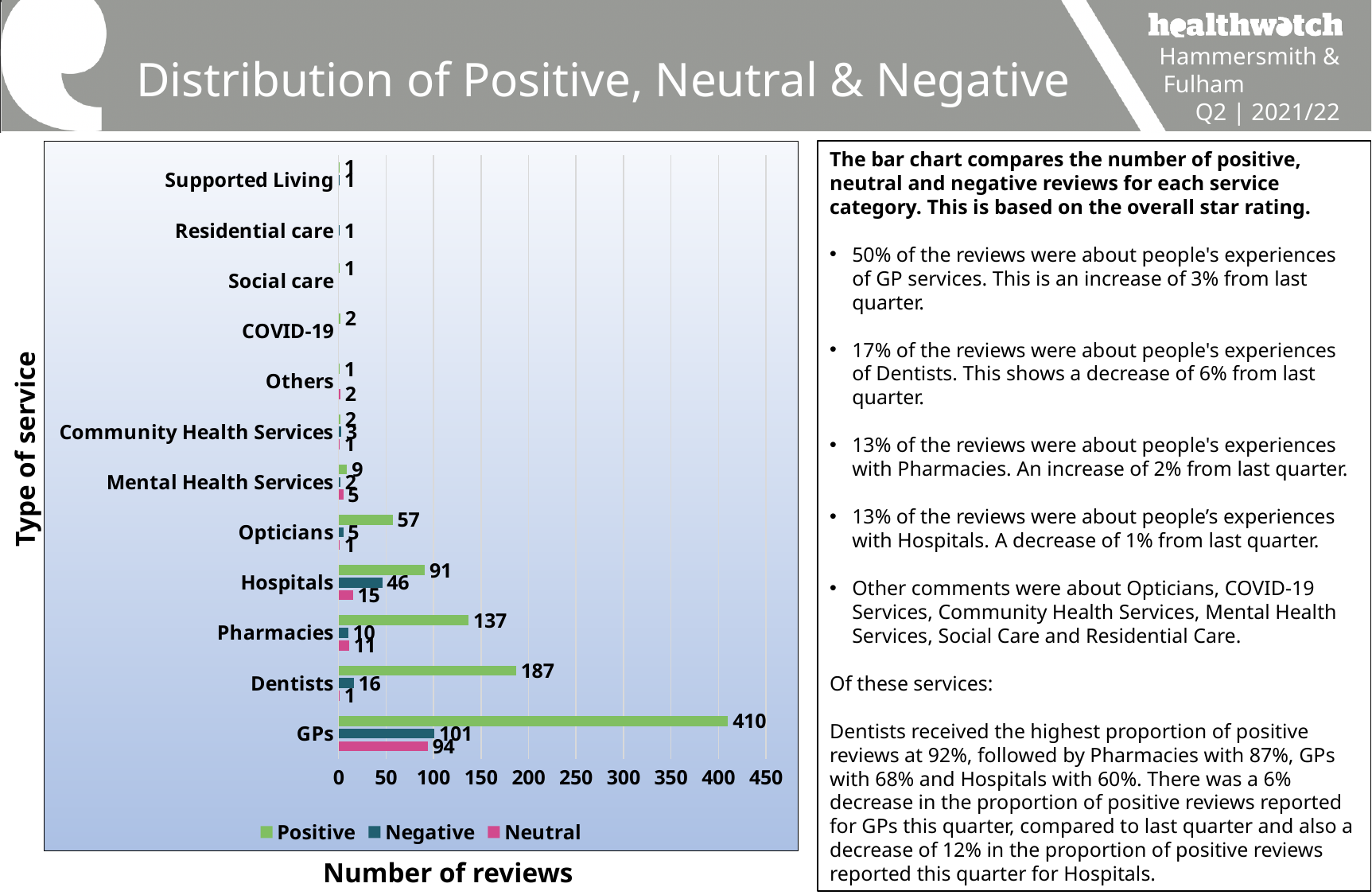
What is the difference between the number of positive and negative reviews for GPs? 309 What is the title of the horizontal axis of the chart? Number of reviews Is the number of positive reviews for Pharmacies greater or less than 100? greater How many negative reviews did Hospitals receive? 46 Which has more negative reviews, Hospitals or Pharmacies? Hospitals How many positive reviews did Dentists receive? 187 What is the number of positive reviews for GPs? 410 How many types of service are shown on the chart? 12 How many series does the legend list? 3 What kind of chart is shown on the slide? Bar chart What is the number of neutral reviews for Pharmacies? 11 Which type of service has the highest number of positive reviews? GPs